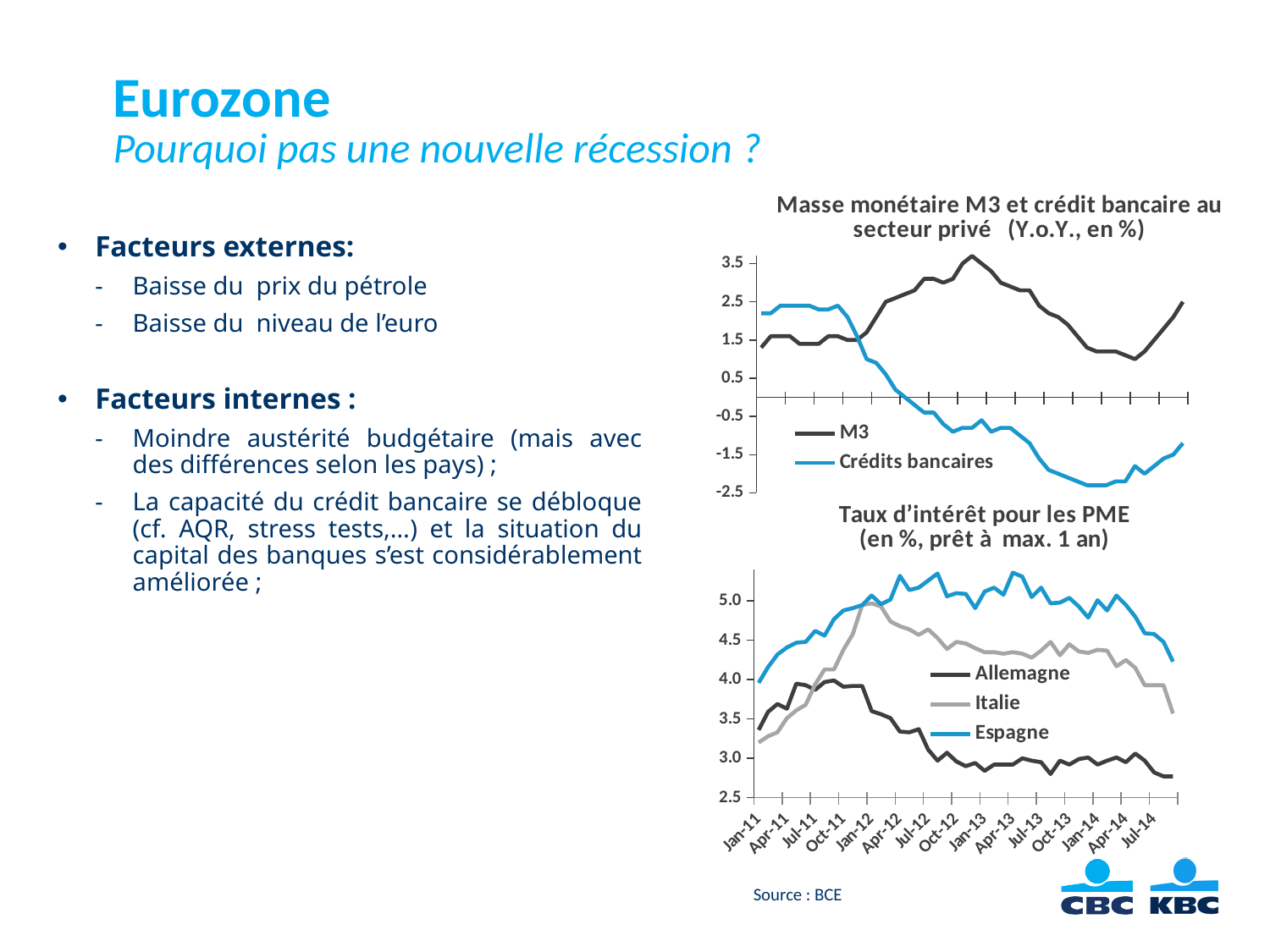
In the chart titled "Taux d'intérêt pour les PME", is the value for Allemagne at Jul-14 greater or less than 3.0? less In the chart titled "Taux d'intérêt pour les PME", which is larger at Jan-12: Italie or Allemagne? Italie In the chart titled "Taux d'intérêt pour les PME", is the value for Italie at Jan-11 greater or less than 3.5? less In the chart titled "Taux d'intérêt pour les PME", which series is listed second in the legend? Italie In the chart titled "Taux d'intérêt pour les PME", which is larger at Jul-14: Espagne or Allemagne? Espagne In the chart titled "Masse monétaire M3 et crédit bancaire au secteur privé", which series reaches the highest value? M3 How many series does the legend of the chart titled "Taux d'intérêt pour les PME" list? 3 In the chart titled "Masse monétaire M3 et crédit bancaire au secteur privé", does the Crédits bancaires series rise or fall overall across the period? fall How many series does the legend of the chart titled "Masse monétaire M3 et crédit bancaire au secteur privé" list? 2 In the chart titled "Taux d'intérêt pour les PME", does the Allemagne series rise or fall overall from Jan-11 to Jul-14? fall What type of chart is the chart titled "Masse monétaire M3 et crédit bancaire au secteur privé"? line chart